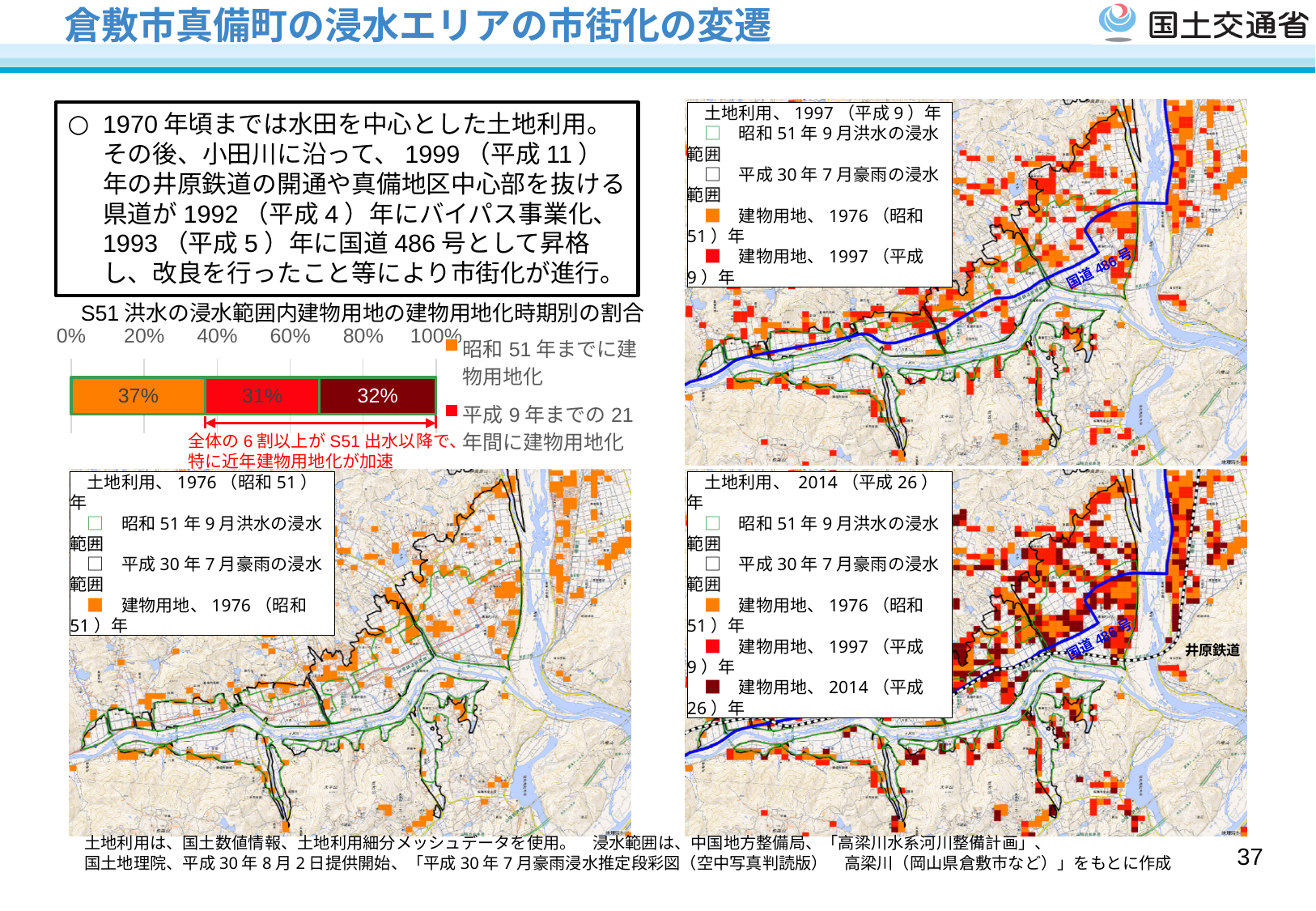
What is the total of the three segments in the stacked bar? 100% In the bar chart, what percentage is shown for 「平成9年までの21年間に建物用地化」? 31% Which is larger: the 「昭和51年までに建物用地化」 segment or the dark red 32% segment? 昭和51年までに建物用地化 What is the difference in percentage points between the 「昭和51年までに建物用地化」 segment and the 「平成9年までの21年間に建物用地化」 segment? 6 percentage points Which segment of the stacked bar has the smallest share? 平成9年までの21年間に建物用地化 (31%) What kind of chart is shown under the title 「S51洪水の浸水範囲内建物用地の建物用地化時期別の割合」? Stacked bar chart Is the value for 「昭和51年までに建物用地化」 greater or less than 20%? greater In the bar chart, what percentage is printed on the dark red (rightmost) segment? 32% How many segments make up the stacked bar? 3 What is the title of the bar chart on the slide? S51洪水の浸水範囲内建物用地の建物用地化時期別の割合 In the bar chart, what percentage is shown for 「昭和51年までに建物用地化」? 37% Which segment of the stacked bar has the largest share? 昭和51年までに建物用地化 (37%)